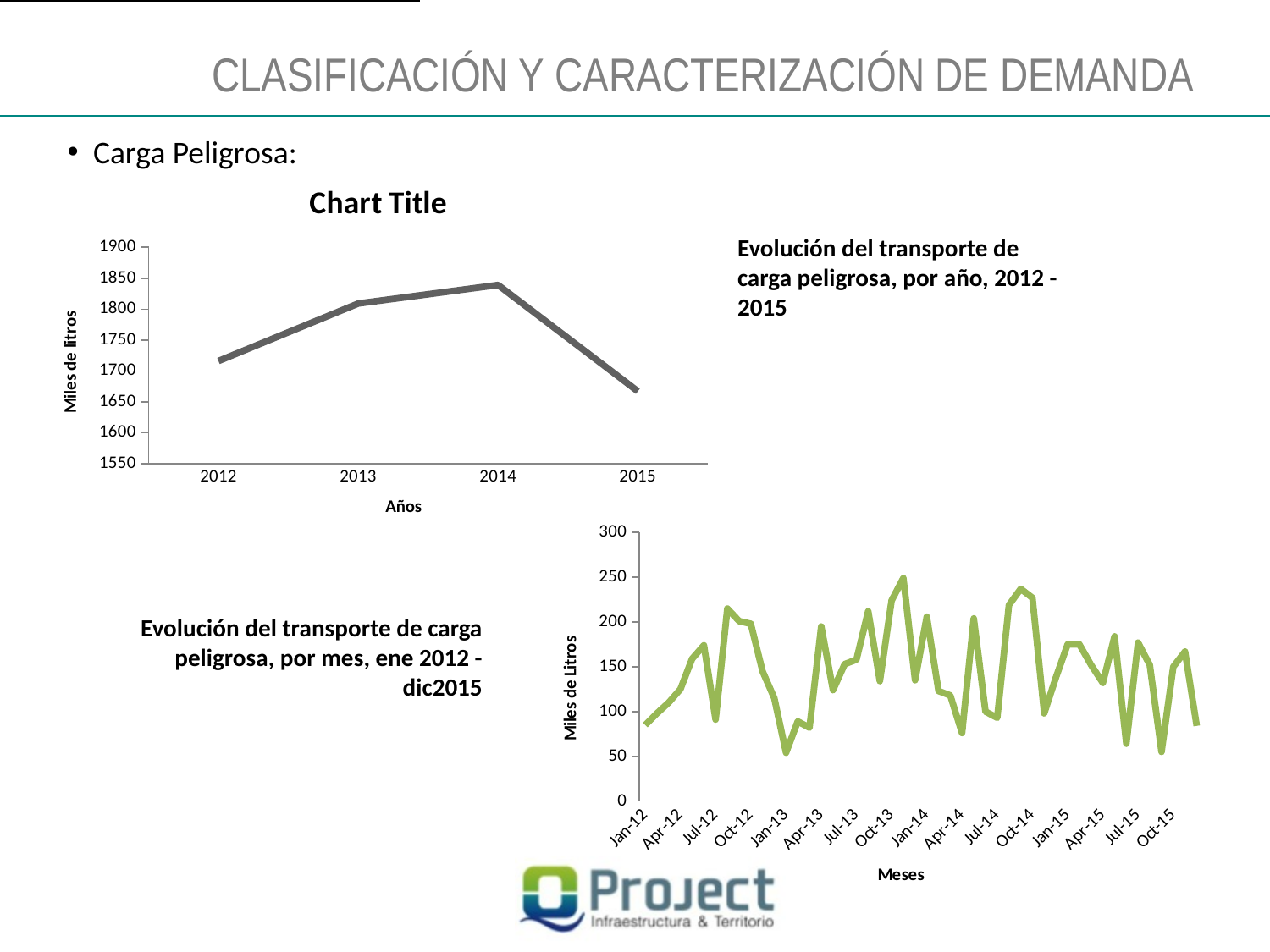
In the top-left chart titled 'Chart Title', which is larger, the value for 2013 or the value for 2015? 2013 What kind of chart is the bottom-right chart with months on the x axis? line chart What is the x-axis title of the top-left chart titled 'Chart Title'? Años In the top-left chart titled 'Chart Title', is the value for 2012 greater or less than 1750? less In the top-left chart titled 'Chart Title', which year has the lowest value? 2015 How many years are plotted on the x axis of the top-left chart titled 'Chart Title'? 4 What is the y-axis title of the bottom-right monthly chart? Miles de Litros In the top-left chart titled 'Chart Title', do the values rise or fall from 2012 to 2014? rise In the top-left chart titled 'Chart Title', is the value for 2015 greater or less than 1700? less In the top-left chart titled 'Chart Title', which year has the highest value? 2014 What kind of chart is the top-left chart titled 'Chart Title'? line chart